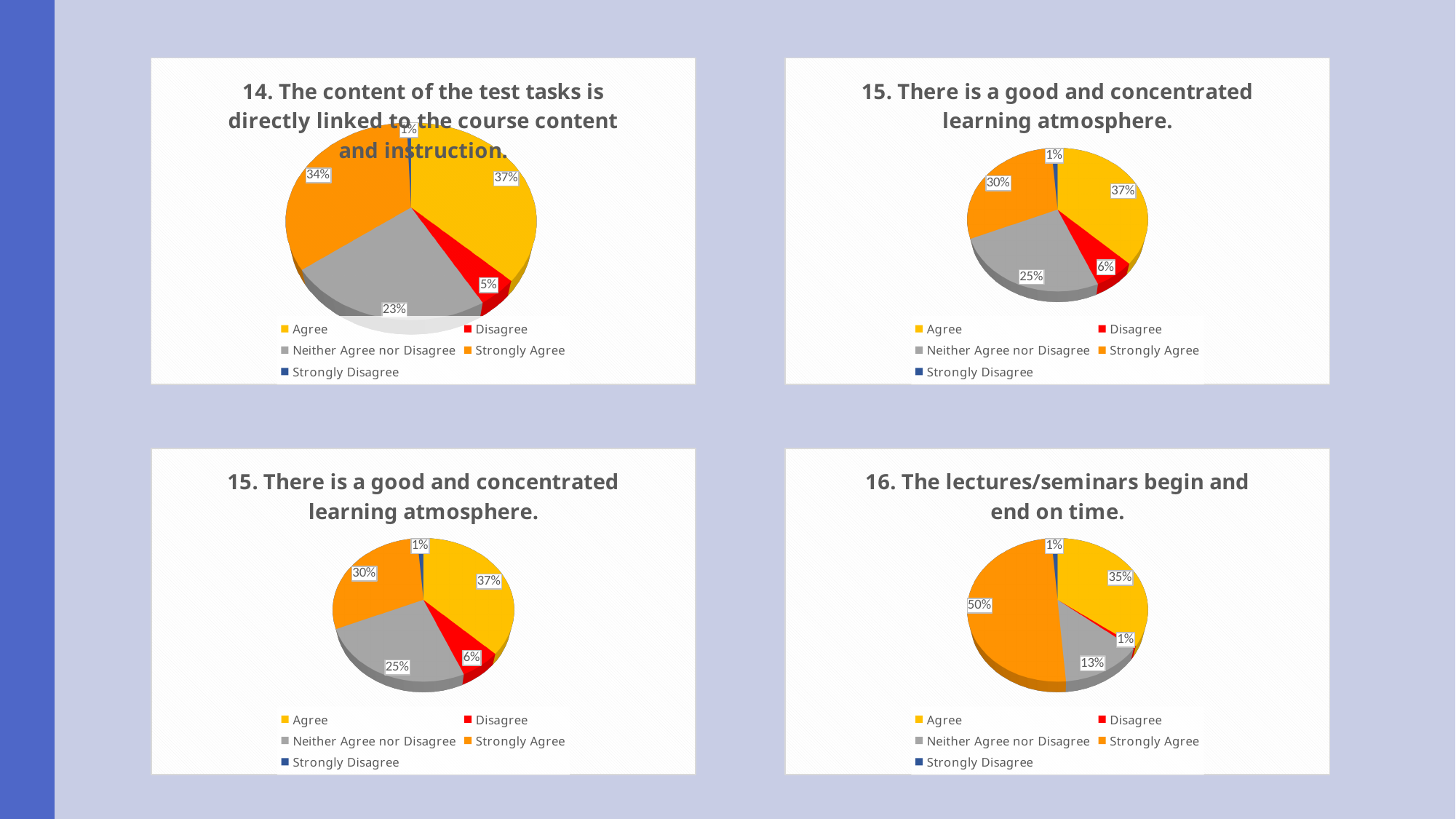
In the bottom-right chart (question 16), what share of responses is Neither Agree nor Disagree? 13% In the top-left chart (question 14), which response category has the largest share? Agree In the top-right chart (question 15), which is larger, the Neither Agree nor Disagree share or the Strongly Agree share? Strongly Agree In the top-left chart (question 14), what share of responses is Agree? 37% In the top-right chart (question 15), what share of responses is Strongly Agree? 30% In the bottom-right chart (question 16), which response category has the largest share? Strongly Agree What type of chart is the bottom-left chart (question 15)? Pie chart In the top-left chart (question 14), what is the difference between the Agree and Strongly Agree shares? 3% In the top-right chart (question 15), what share of responses is Disagree? 6% In the top-left chart (question 14), what share of responses is Neither Agree nor Disagree? 23% How many categories does the legend of the bottom-right chart (question 16) list? 5 In the bottom-right chart (question 16), what share of responses is Strongly Agree? 50%